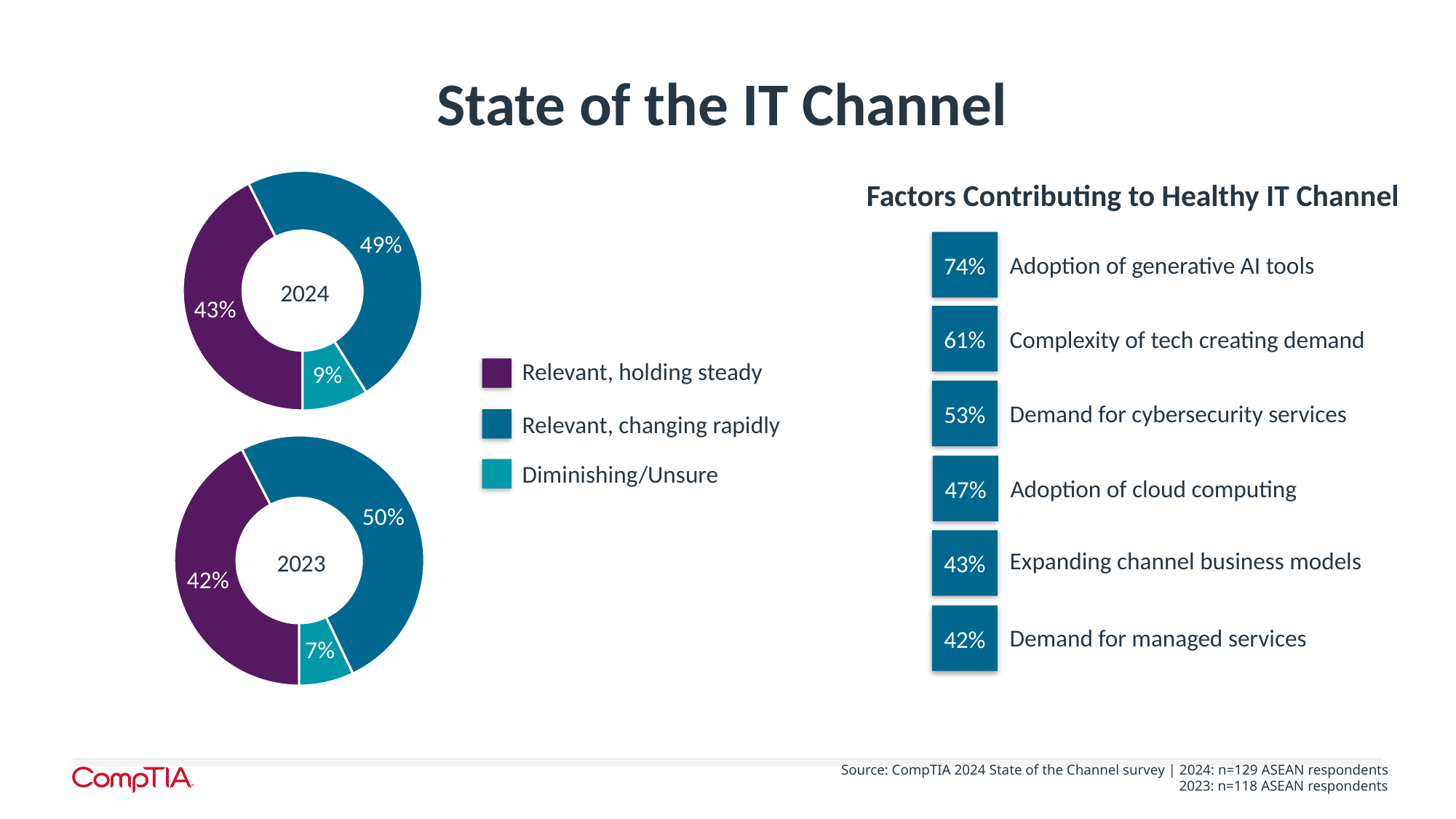
In the 2024 donut chart, which category has the largest share? Relevant, changing rapidly What type of chart is used to show the 2024 and 2023 data on the left of the slide? Donut chart In the 2024 donut chart, what is the difference between the Relevant, holding steady share and the Diminishing/Unsure share? 34 percentage points In the 2023 donut chart, what share of respondents said the IT channel is relevant, holding steady? 42% What is the difference between the Relevant, changing rapidly share in 2023 and in 2024? 1 percentage point Which colour represents Relevant, holding steady in the donut charts? Purple How many categories does each donut chart show? 3 Is the Diminishing/Unsure share larger in the 2024 donut chart or the 2023 donut chart? 2024 In the 2023 donut chart, what is the value for Diminishing/Unsure? 7% In the 2024 donut chart, what share of respondents said the IT channel is relevant, changing rapidly? 49% In the 2023 donut chart, which category has the smallest share? Diminishing/Unsure In the 2024 donut chart, what is the value for Diminishing/Unsure? 9%